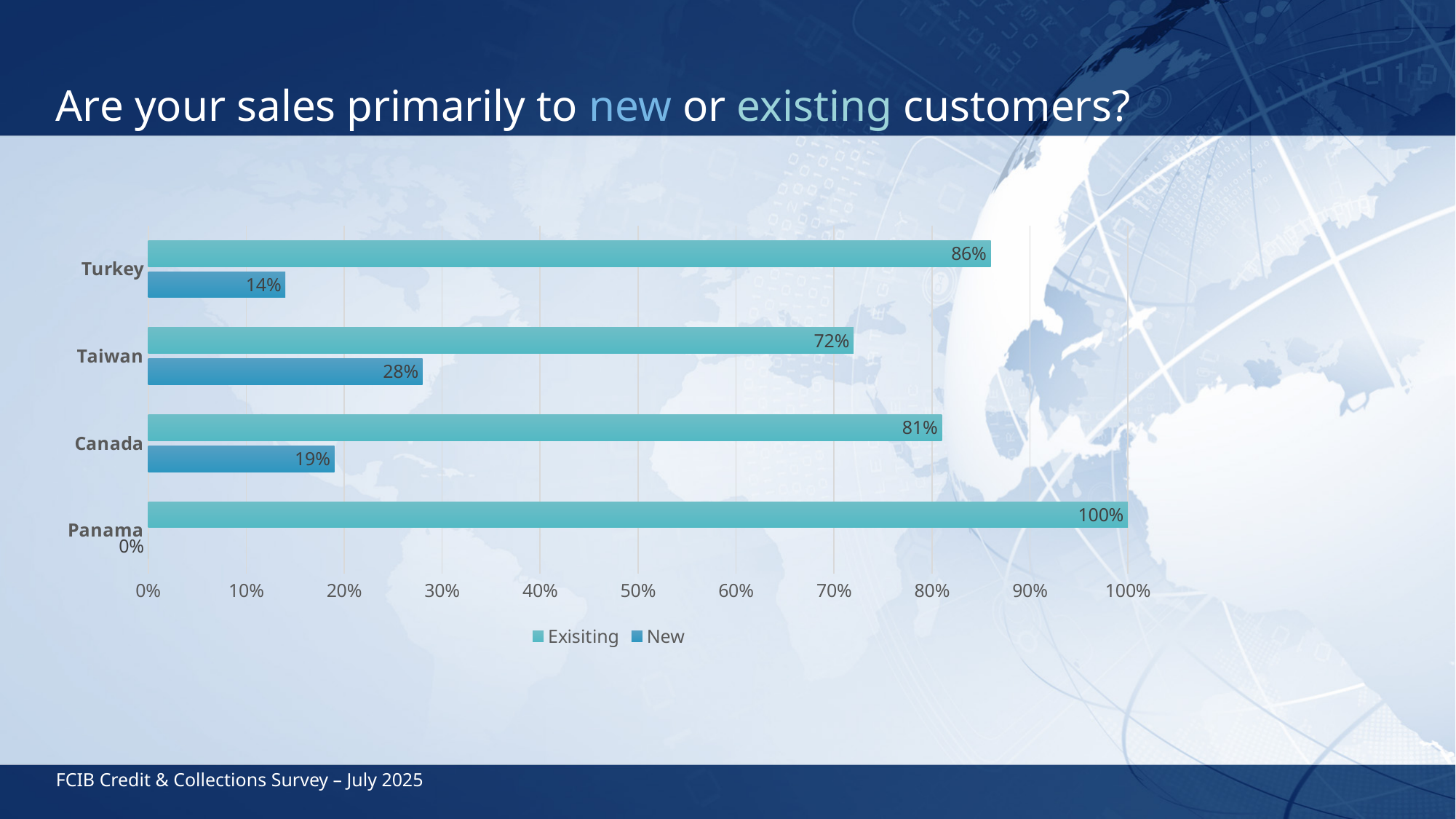
What is the value for New customers for Panama? 0% What percentage of Turkey's sales are to existing customers? 86% Which country has the highest value for Existing customers? Panama What is the value for New customers for Taiwan? 28% Which is larger, the New value for Canada or the New value for Turkey? Canada Which country has the lowest value for Existing customers? Taiwan How many countries are shown on the chart? 4 What is the value for Existing customers for Canada? 81% What type of chart is shown on the slide? Bar chart What is the difference between the Existing and New values for Turkey? 72% How many series does the legend list? 2 Which country has the highest value for New customers? Taiwan